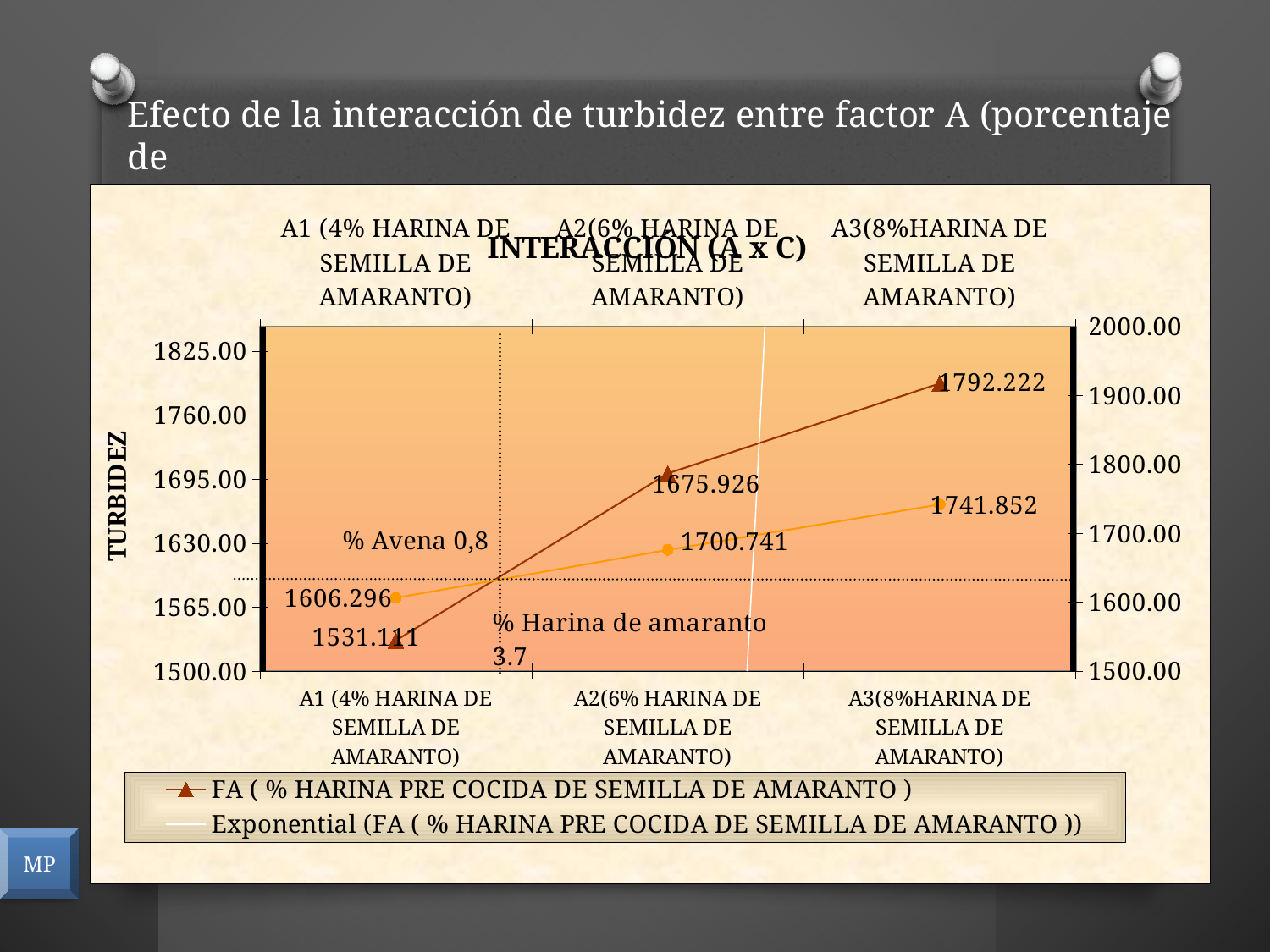
What type of chart is shown on the slide? line chart What is the value of the orange line with circle markers at A3 (8% HARINA DE SEMILLA DE AMARANTO)? 1741.852 At which category does the FA (% HARINA PRE COCIDA DE SEMILLA DE AMARANTO) series reach its highest value? A3 (8% HARINA DE SEMILLA DE AMARANTO) What is the value of the FA (% HARINA PRE COCIDA DE SEMILLA DE AMARANTO) series at A3 (8% HARINA DE SEMILLA DE AMARANTO)? 1792.222 What is the value of the FA (% HARINA PRE COCIDA DE SEMILLA DE AMARANTO) series at A2 (6% HARINA DE SEMILLA DE AMARANTO)? 1700.741 How many categories are shown on the x axis? 3 What is the title of the chart? INTERACCIÓN (A x C) What is the value of the FA (% HARINA PRE COCIDA DE SEMILLA DE AMARANTO) series at A1 (4% HARINA DE SEMILLA DE AMARANTO)? 1531.111 What is the value of the orange line with circle markers at A1 (4% HARINA DE SEMILLA DE AMARANTO)? 1606.296 At which category does the FA (% HARINA PRE COCIDA DE SEMILLA DE AMARANTO) series have its lowest value? A1 (4% HARINA DE SEMILLA DE AMARANTO) What is the difference between the FA series values at A3 (1792.222) and A1 (1531.111)? 261.111 Does the FA (% HARINA PRE COCIDA DE SEMILLA DE AMARANTO) series rise or fall from A1 to A3? rise